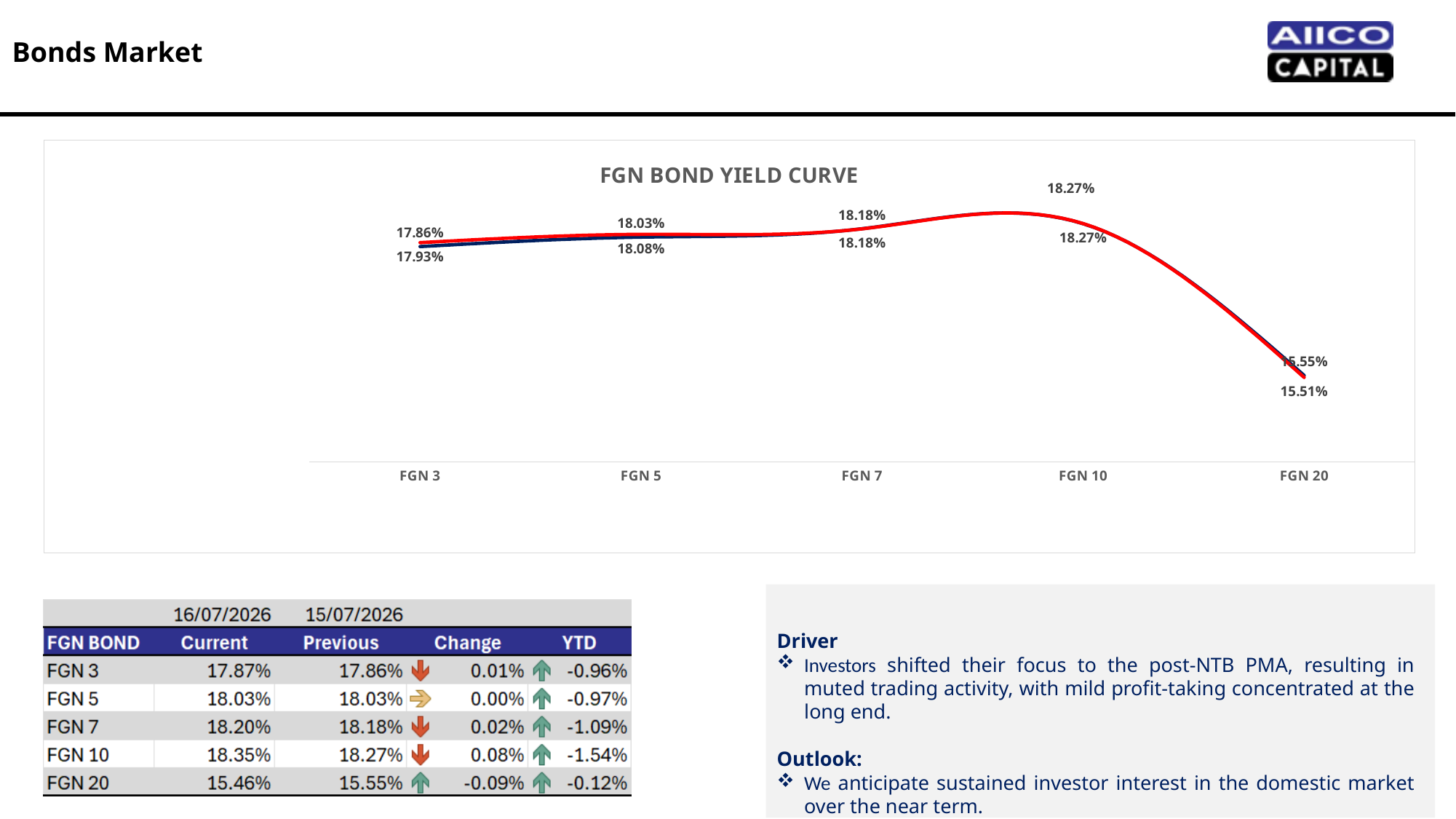
Is the yield higher at FGN 10 or at FGN 20? FGN 10 What is the lower data label shown at FGN 20? 15.51% How many lines are plotted on the chart? 2 How many bond categories are shown on the x axis of the chart? 5 What is the title of the chart? FGN BOND YIELD CURVE What value is labelled for both lines at FGN 10? 18.27% What is the lower data label shown at FGN 3? 17.93% What is the upper data label shown at FGN 3? 17.86% Which bond has the lowest yield on the chart? FGN 20 What kind of chart is the FGN BOND YIELD CURVE? line chart What is the difference between the two data labels shown at FGN 3? 0.07% Which bond has the highest yield on the chart? FGN 10